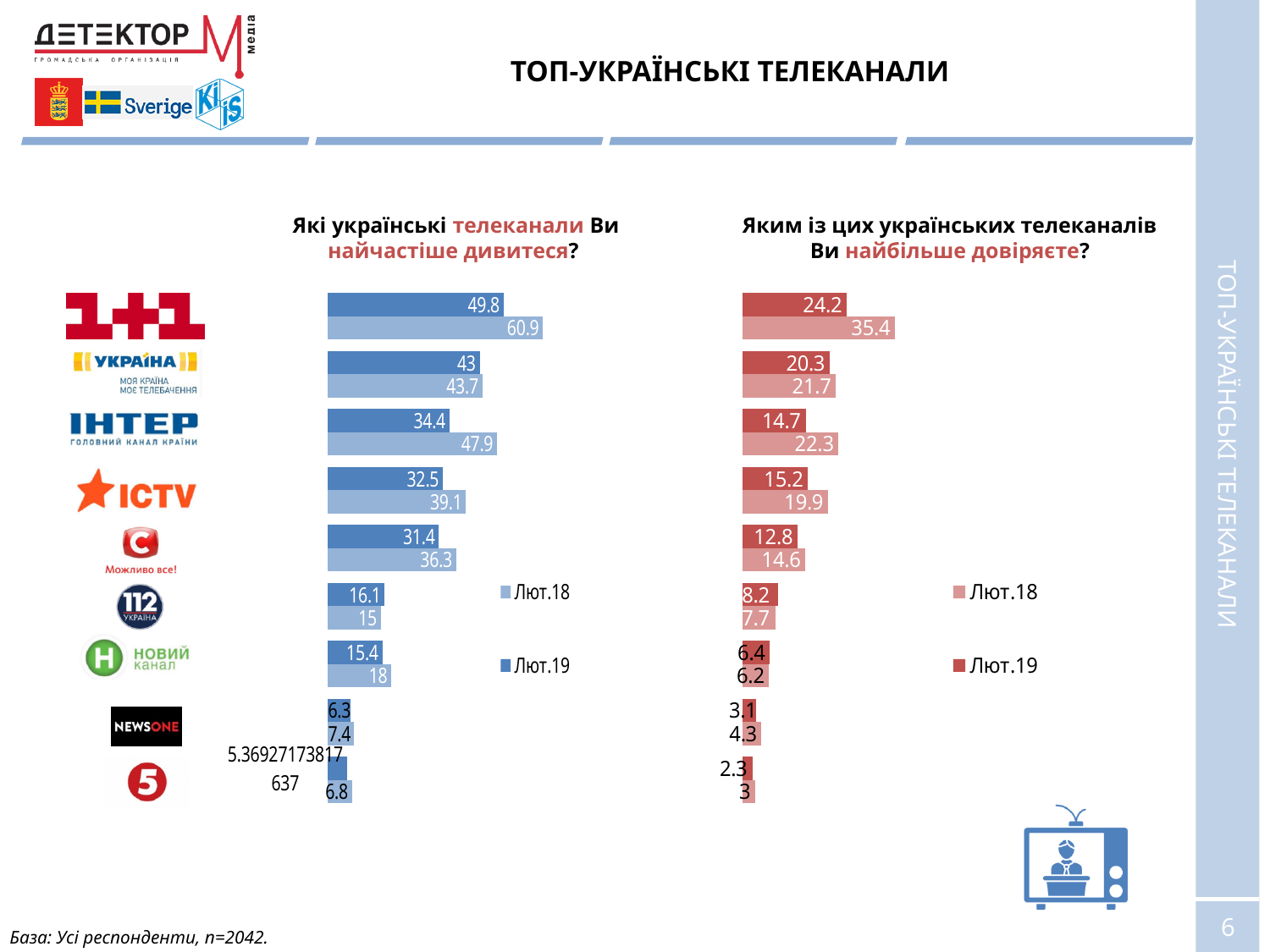
On the right chart ("Яким із цих українських телеканалів Ви найбільше довіряєте?"), what is the difference between the Лют.18 and Лют.19 values for Інтер? 7.6 On the left chart ("Які українські телеканали Ви найчастіше дивитеся?"), which is larger for 112 Україна: the Лют.18 value or the Лют.19 value? Лют.19 On the left chart ("Які українські телеканали Ви найчастіше дивитеся?"), what is the Лют.18 value for Інтер? 47.9 On the left chart ("Які українські телеканали Ви найчастіше дивитеся?"), which channel has the highest Лют.18 value? 1+1 On the right chart ("Яким із цих українських телеканалів Ви найбільше довіряєте?"), what is the Лют.19 value for ICTV? 15.2 On the left chart ("Які українські телеканали Ви найчастіше дивитеся?"), what is the difference between the Лют.18 and Лют.19 values for 1+1? 11.1 What kind of chart is the right chart ("Яким із цих українських телеканалів Ви найбільше довіряєте?")? Bar chart On the left chart ("Які українські телеканали Ви найчастіше дивитеся?"), what is the Лют.19 value for 1+1? 49.8 On the right chart ("Яким із цих українських телеканалів Ви найбільше довіряєте?"), which channel has the lowest Лют.19 value? 5 канал On the right chart ("Яким із цих українських телеканалів Ви найбільше довіряєте?"), what is the Лют.18 value for 1+1? 35.4 How many series does the legend of the right chart ("Яким із цих українських телеканалів Ви найбільше довіряєте?") list? 2 How many channels are shown on the left chart ("Які українські телеканали Ви найчастіше дивитеся?")? 9